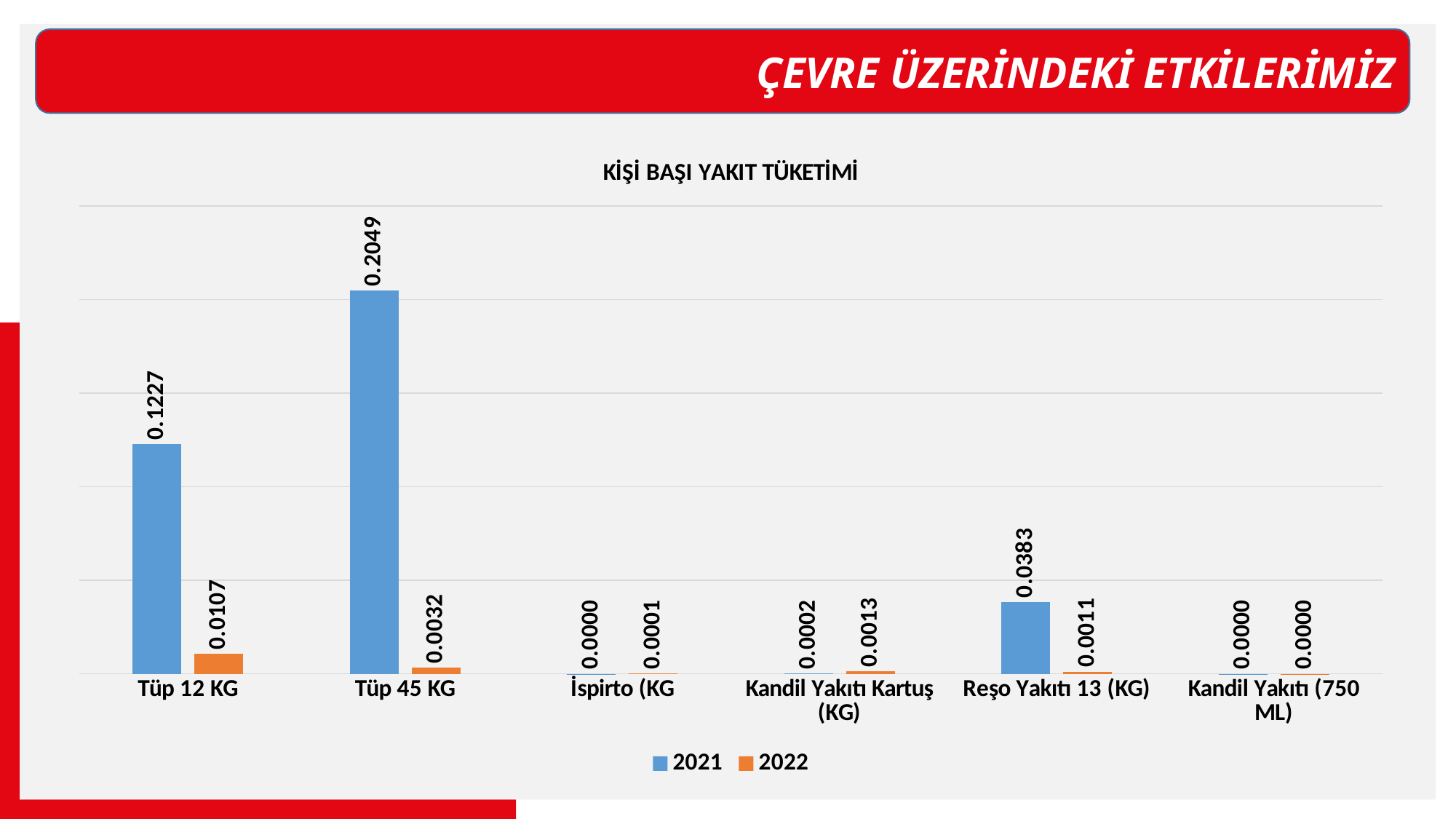
What is the difference between the 2021 and 2022 values for Tüp 12 KG? 0.1120 How many categories are shown on the x axis? 6 Which is larger for Reşo Yakıtı 13 (KG): the 2021 value or the 2022 value? 2021 What is the 2022 value for Tüp 12 KG? 0.0107 What kind of chart is shown on the slide? Bar chart Which category has the highest 2022 value? Tüp 12 KG What is the 2022 value for Kandil Yakıtı Kartuş (KG)? 0.0013 How many series does the legend list? 2 What is the 2021 value for Reşo Yakıtı 13 (KG)? 0.0383 What is the difference between the 2021 values for Tüp 45 KG and Tüp 12 KG? 0.0822 What is the 2021 value for Tüp 45 KG? 0.2049 Which category has the highest 2021 value? Tüp 45 KG